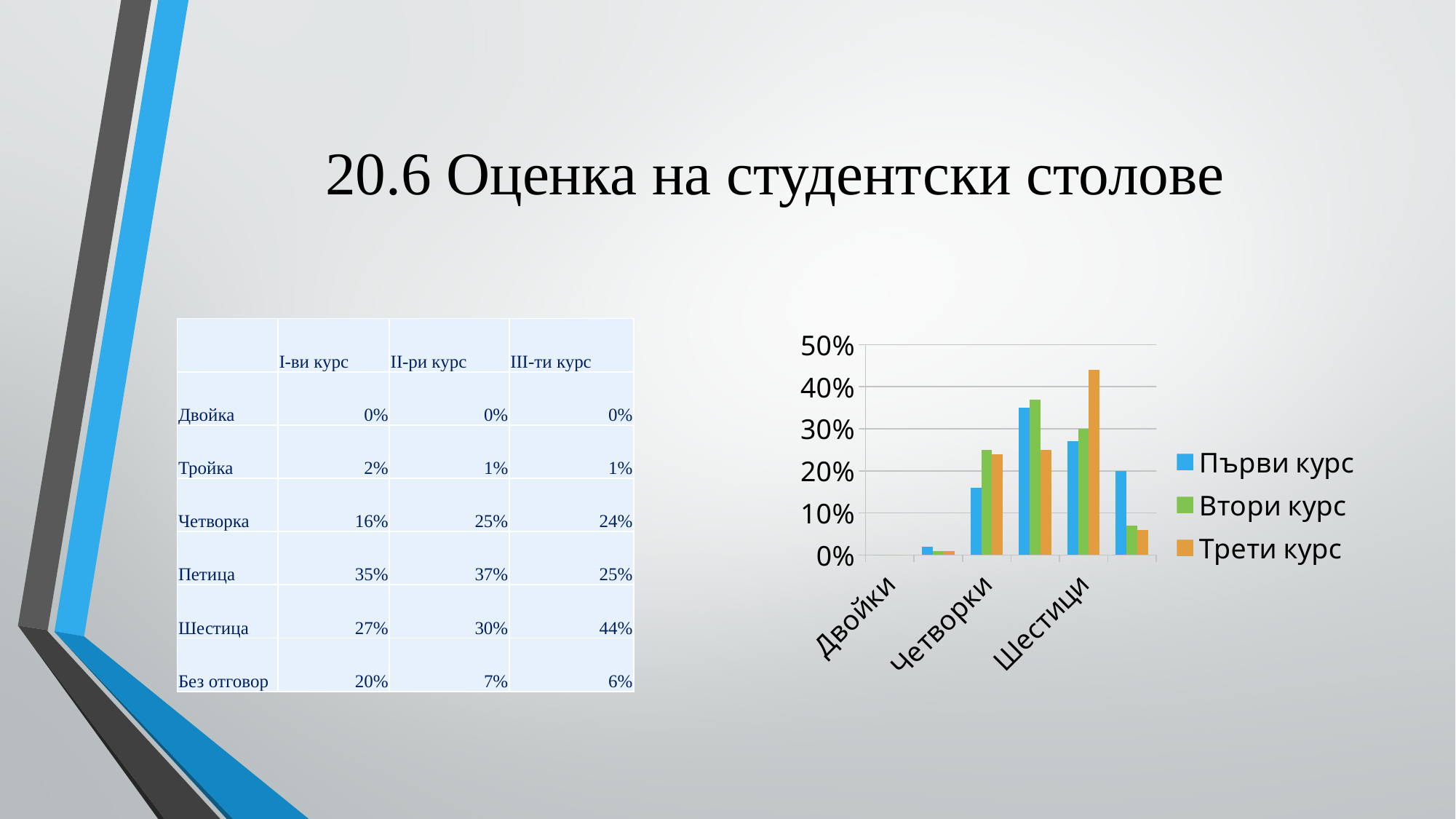
Is the value for Първи курс in the Шестици group greater or less than 30%? less According to the table, what is the value for Шестица for III-ти курс? 44% Which series has the tallest bar in the Шестици group? Трети курс Is the value for Първи курс in the Четворки group greater or less than 20%? less Which series has the tallest bar in the Без отговор group (the last group)? Първи курс How many series does the chart's legend list? 3 According to the table, what is the value for Без отговор for I-ви курс? 20% What kind of chart is shown on the slide? bar chart What are the three series named in the chart's legend? Първи курс, Втори курс, Трети курс Using the table values, what is the difference between III-ти курс and I-ви курс for Шестица? 17 percentage points Which is larger: the Шестици bar for Трети курс or the Шестици bar for Втори курс? Трети курс Is the value for Трети курс in the Шестици group greater or less than 40%? greater